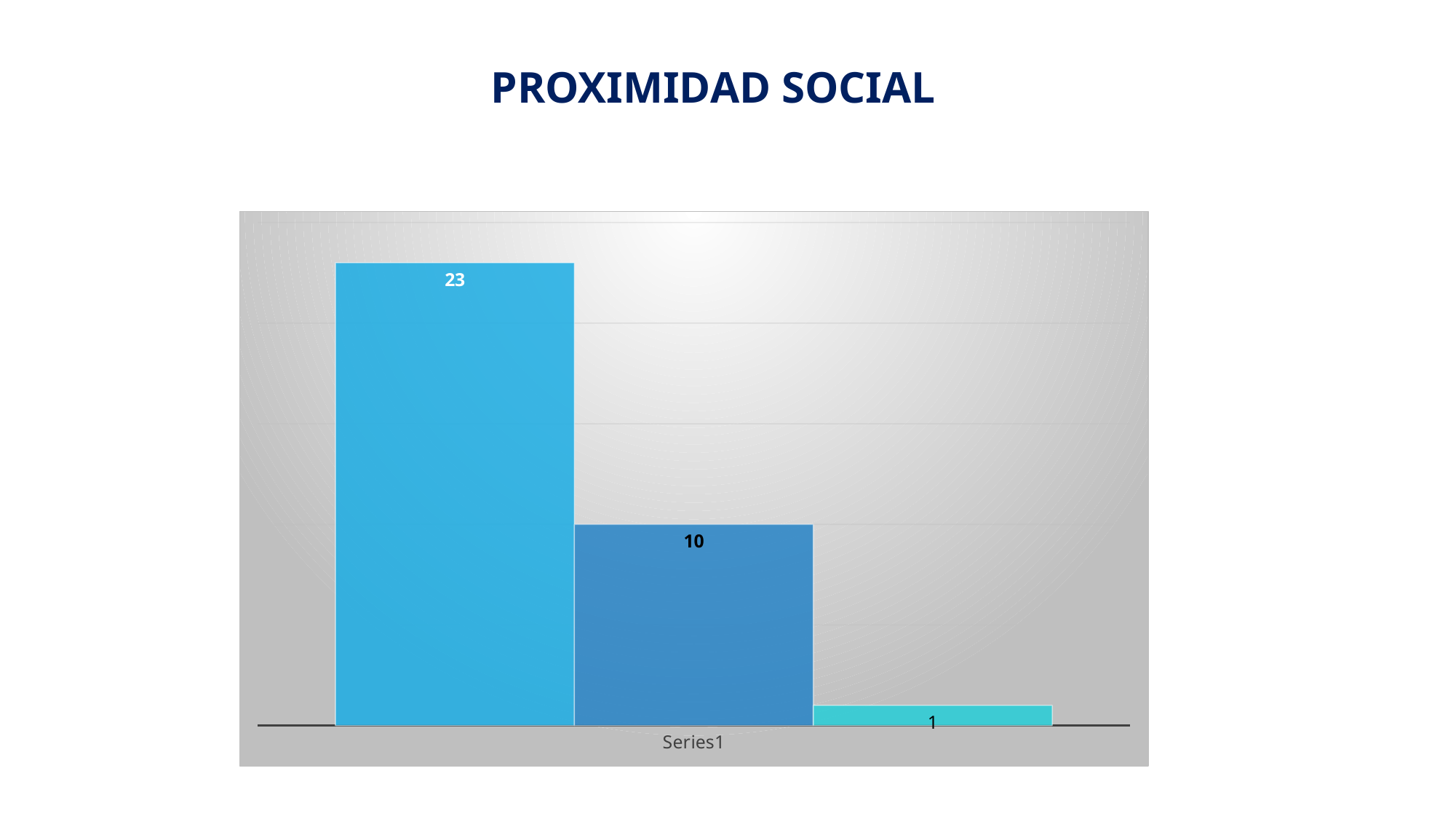
How many bars are plotted in the chart? 3 Which bar has the lowest value: the left, middle or right one? right What is the value shown on the rightmost bar? 1 What is the value shown on the middle bar? 10 What is the value shown on the leftmost bar? 23 Which is larger, the value of the middle bar or the value of the rightmost bar? the middle bar Which bar has the highest value: the left, middle or right one? left What is the title of the slide? PROXIMIDAD SOCIAL Do the bar values rise or fall from left to right? fall What is the difference between the values of the middle bar and the rightmost bar? 9 What is the difference between the values of the leftmost bar and the middle bar? 13 What kind of chart is shown on the slide? bar chart